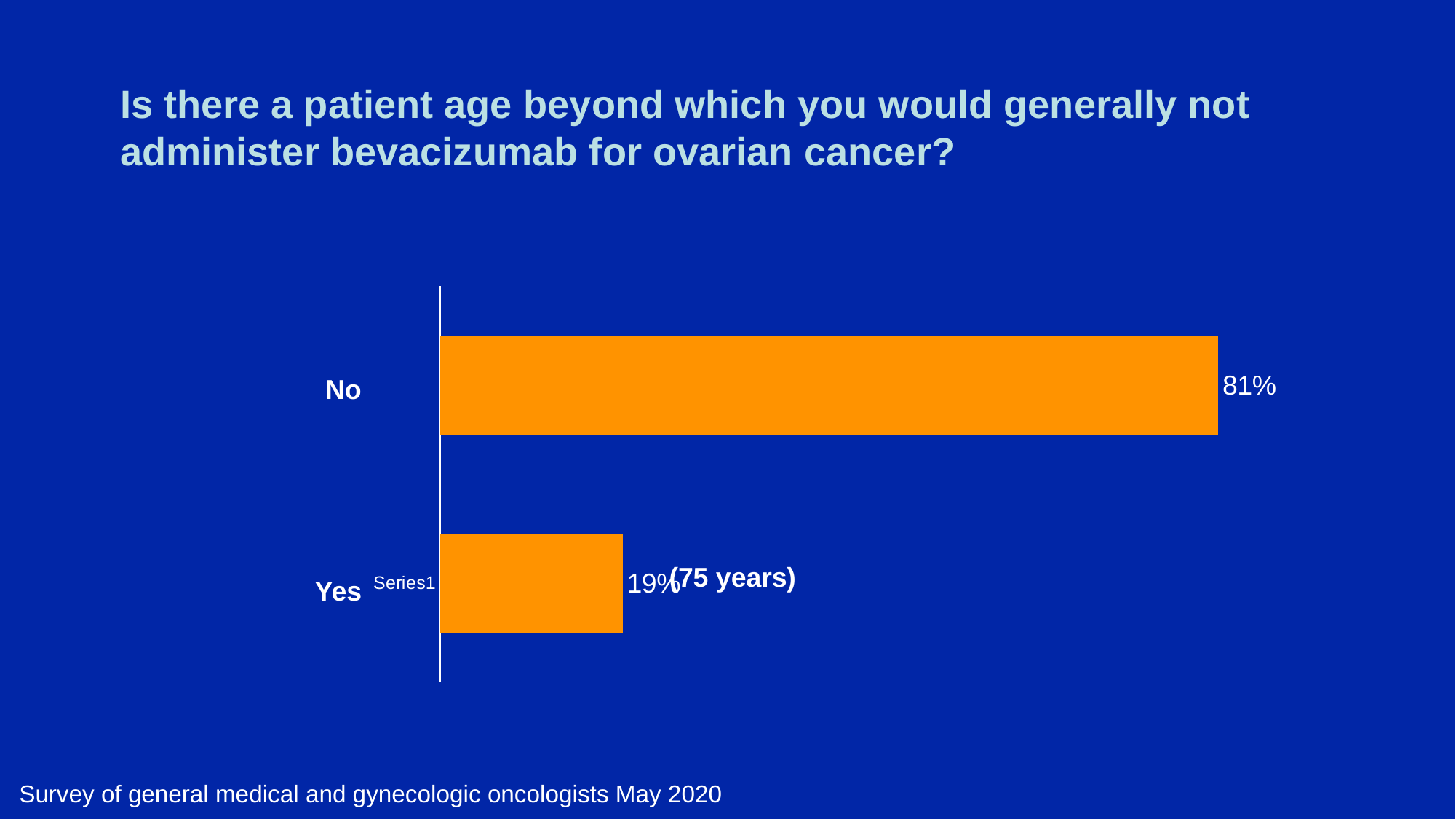
How many response categories are shown in the chart? 2 What kind of chart is shown on the slide? Bar chart What is the total of the "No" and "Yes" percentages? 100% What colour are the bars in the chart? Orange Which response category has the highest value? No What percentage of respondents answered "No"? 81% Which is larger, the value for "No" or the value for "Yes"? No What percentage of respondents answered "Yes"? 19% What is the difference between the "No" and "Yes" percentages? 62% Which response category has the lowest value? Yes What age is given in parentheses next to the "Yes" bar? 75 years